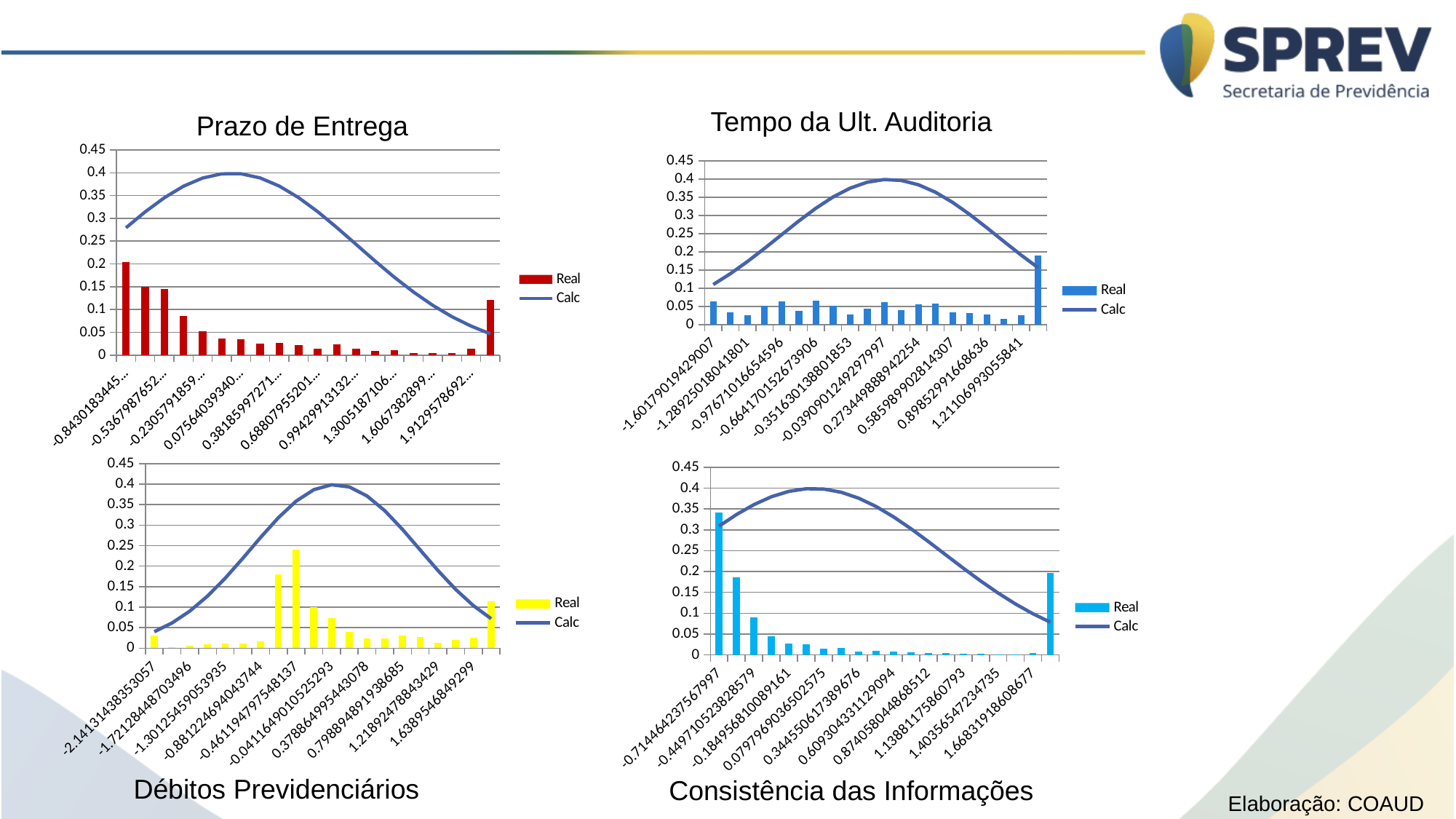
What are the two legend entries in the 'Tempo da Ult. Auditoria' chart? Real and Calc In the 'Prazo de Entrega' chart, is the peak of the 'Calc' line greater or less than 0.35? greater How many series does the legend of the 'Prazo de Entrega' chart list? 2 In the 'Consistência das Informações' chart, which is larger: the first (leftmost) 'Real' bar or the last (rightmost) 'Real' bar? The first (leftmost) In the 'Tempo da Ult. Auditoria' chart, which 'Real' bar is the highest? The last (rightmost) bar In the 'Prazo de Entrega' chart, which 'Real' bar is the highest: the first (leftmost) or the last (rightmost)? The first (leftmost) What kind of chart is used for the 'Real' series in the 'Consistência das Informações' chart? Bar chart In the 'Consistência das Informações' chart, is the value of the first (leftmost) 'Real' bar greater or less than 0.3? greater In the 'Tempo da Ult. Auditoria' chart, is the value of the last (rightmost) 'Real' bar greater or less than 0.15? greater What colour are the 'Real' bars in the 'Débitos Previdenciários' chart? Yellow